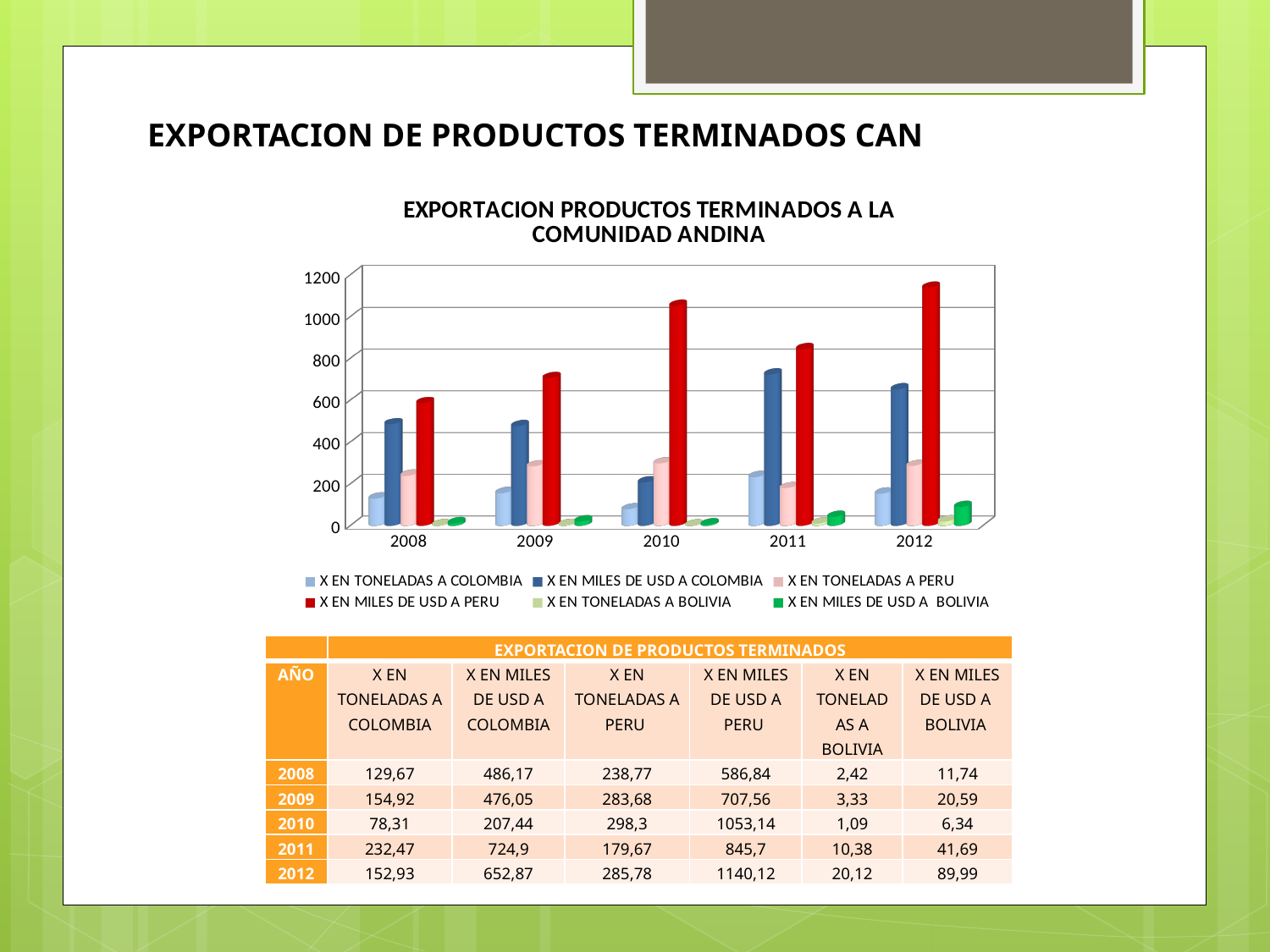
What is the title of the chart? EXPORTACION PRODUCTOS TERMINADOS A LA COMUNIDAD ANDINA What is the value for X EN TONELADAS A COLOMBIA in 2011? 232,47 In which year is the value for X EN MILES DE USD A COLOMBIA the lowest? 2010 What is the difference between the X EN MILES DE USD A PERU values for 2012 and 2011? 294,42 What kind of chart is shown on the slide? bar chart Is the value for X EN MILES DE USD A COLOMBIA in 2011 greater or less than 600? greater How many years are shown on the x axis of the chart? 5 What is the value for X EN MILES DE USD A PERU in 2010? 1053,14 In which year is the value for X EN MILES DE USD A PERU the highest? 2012 Is the value for X EN MILES DE USD A PERU in 2010 greater or less than 1000? greater How many series does the chart legend list? 6 In 2011, which is larger: X EN MILES DE USD A COLOMBIA or X EN MILES DE USD A PERU? X EN MILES DE USD A PERU